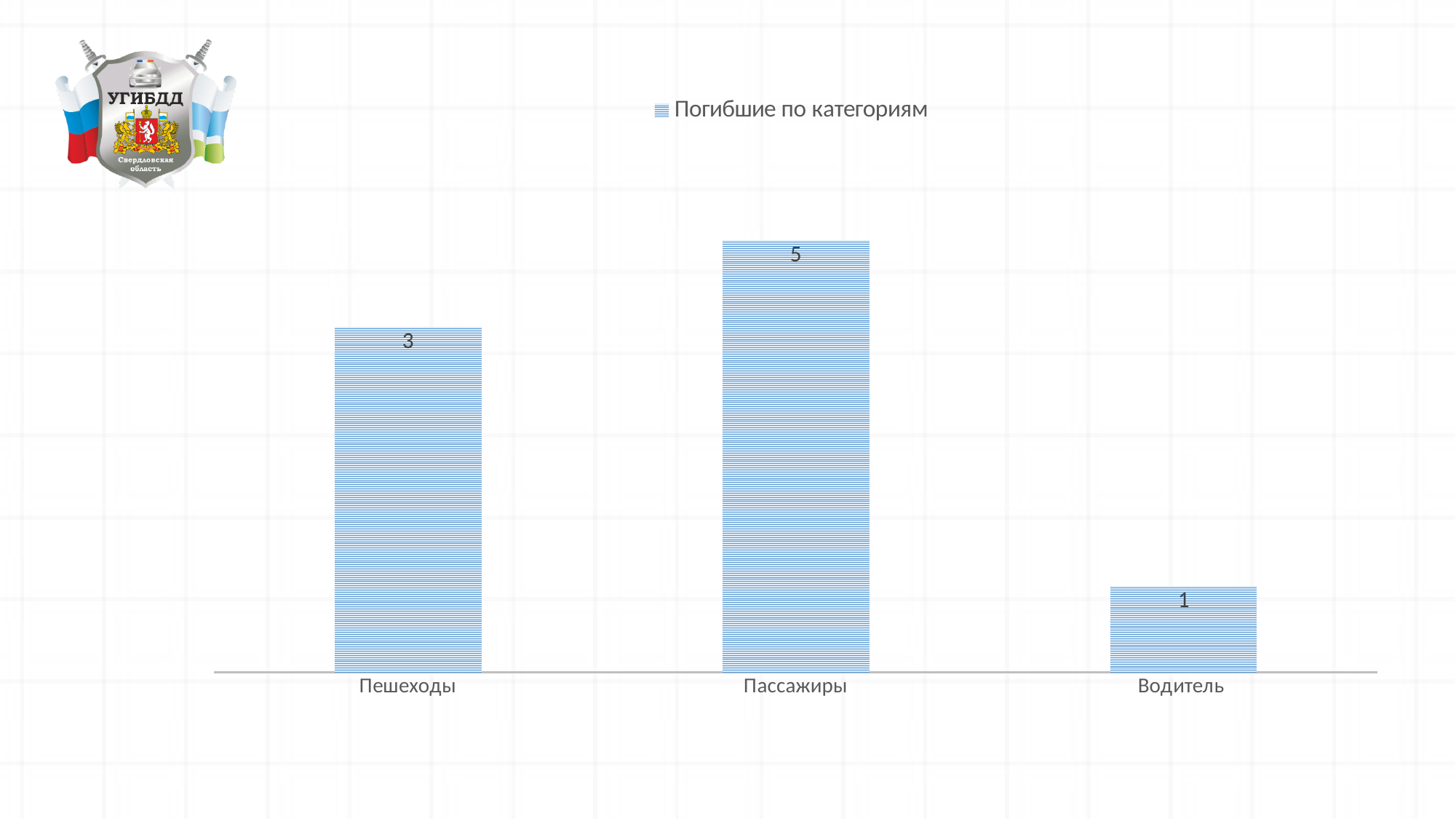
What is the value for Пешеходы? 3 What is the value for Пассажиры? 5 What is the series name shown in the legend? Погибшие по категориям How many categories are shown on the chart? 3 What kind of chart is shown on the slide? bar chart What is the difference between the values for Пешеходы and Водитель? 2 How many series does the legend list? 1 What is the difference between the values for Пассажиры and Пешеходы? 2 Which category has the highest value? Пассажиры What is the value for Водитель? 1 Which is larger, the value for Пешеходы or the value for Водитель? Пешеходы Which category has the lowest value? Водитель